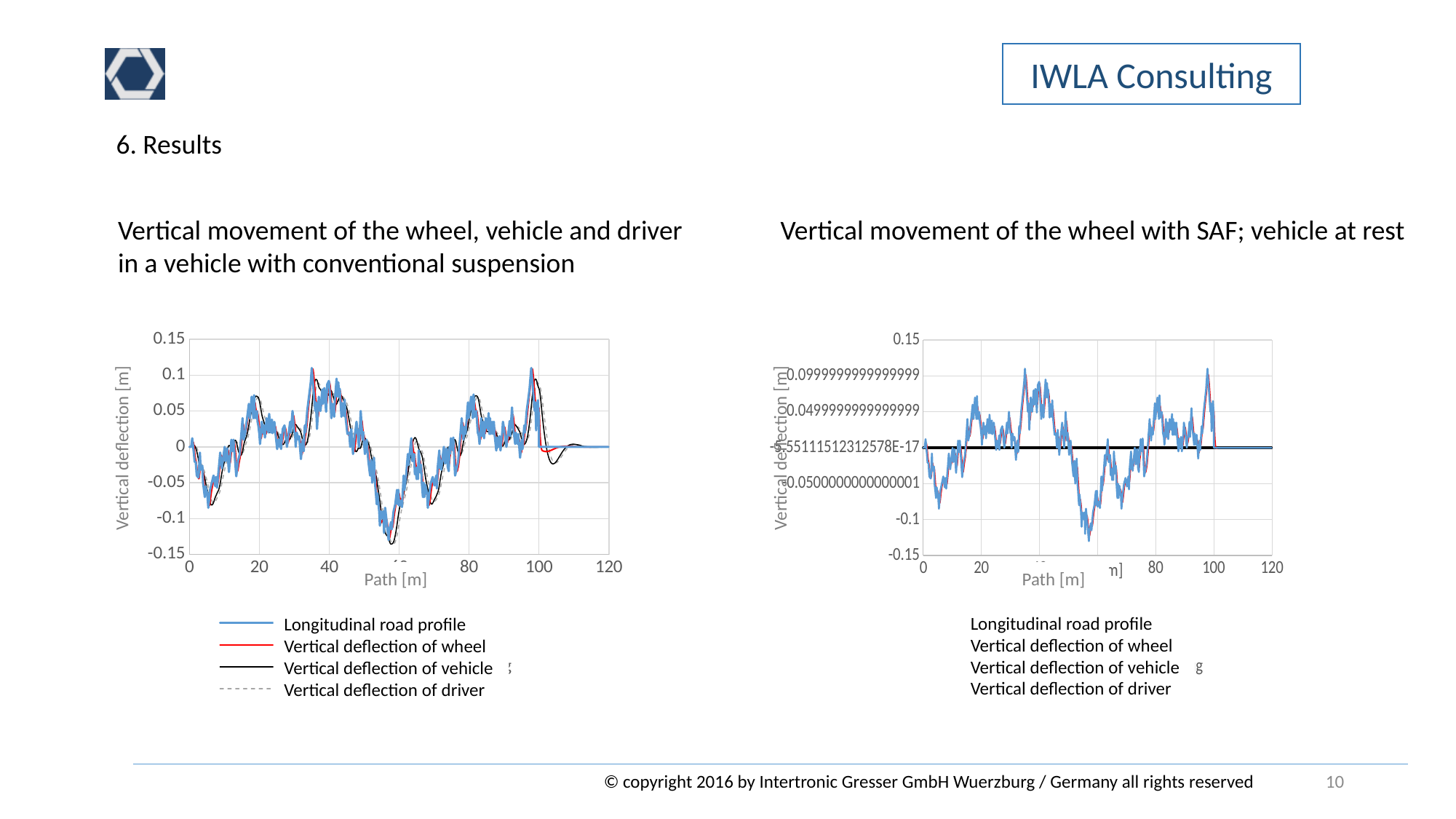
In the left chart, is the lowest value of the longitudinal road profile (near 57 m along the path) greater or less than -0.1? less How many series does the legend of the right chart, 'Vertical movement of the wheel with SAF; vehicle at rest', list? 4 In the left chart, what is the highest value shown on the x axis? 120 In the right chart, does the vertical deflection of vehicle series vary along the path or stay flat? Stays flat at 0 How many series does the legend of the left chart list? 4 What kind of chart is the left chart, titled 'Vertical movement of the wheel, vehicle and driver in a vehicle with conventional suspension'? Line chart In the left chart, what is the label of the x axis? Path [m] In the right chart, is the peak of the longitudinal road profile near 35 m along the path greater or less than 0.05? greater In the left chart, is the peak of the longitudinal road profile near 35 m along the path greater or less than 0.05? greater In the left chart, what is the label of the y axis? Vertical deflection [m]